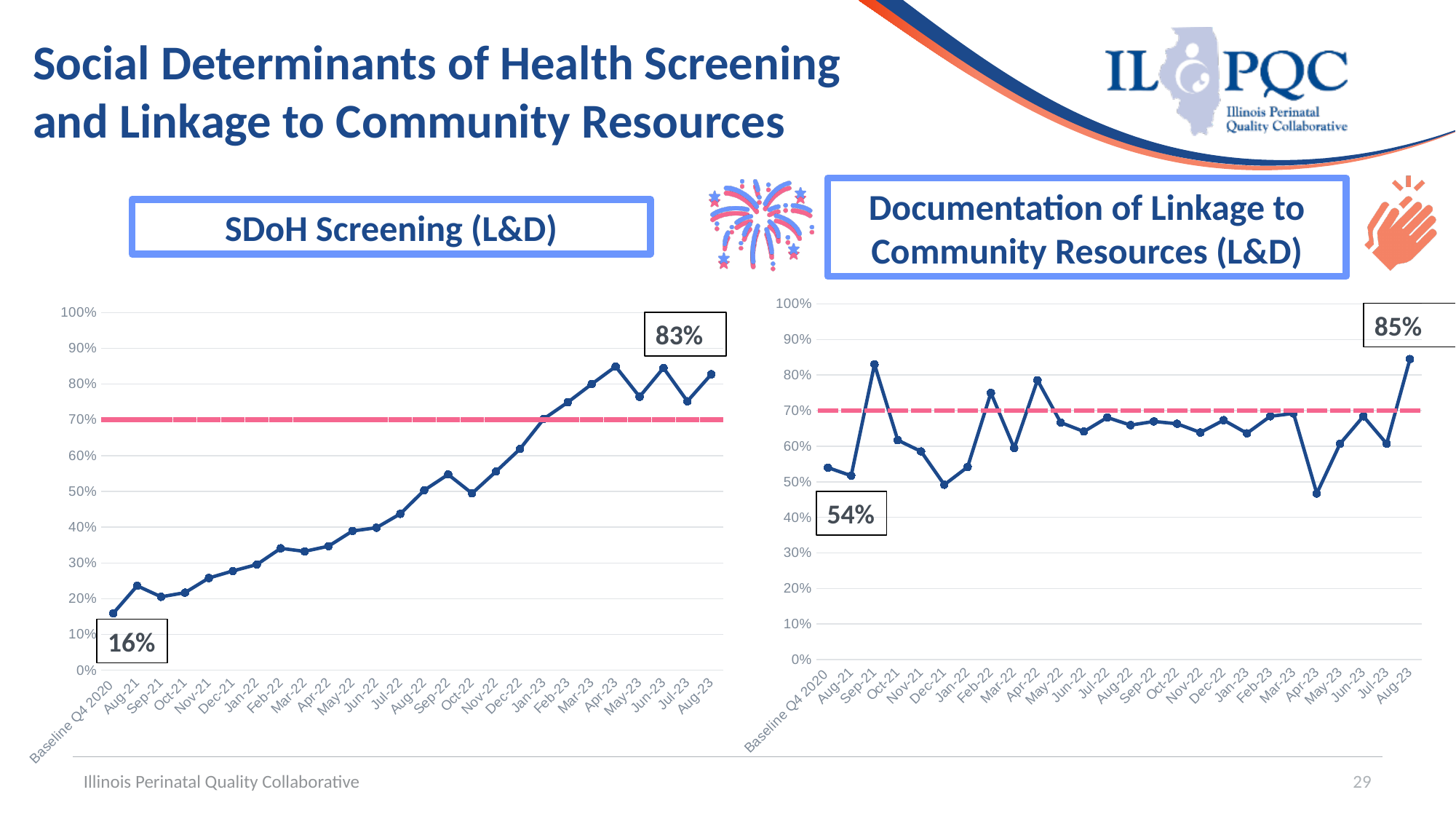
On the SDoH Screening (L&D) chart, which time point has the lowest value? Baseline Q4 2020 On the SDoH Screening (L&D) chart, by how many percentage points did the value increase from Baseline Q4 2020 to Aug-23? 67 percentage points On the SDoH Screening (L&D) chart, what is the value for Baseline Q4 2020? 16% On the SDoH Screening (L&D) chart, do the values generally rise or fall from Baseline Q4 2020 to Aug-23? Rise On the SDoH Screening (L&D) chart, what is the value for Aug-23? 83% On the Documentation of Linkage to Community Resources (L&D) chart, what is the difference between the Aug-23 value and the Baseline Q4 2020 value? 31 percentage points On the Documentation of Linkage to Community Resources (L&D) chart, what is the value for Baseline Q4 2020? 54% What kind of chart is the SDoH Screening (L&D) chart? Line chart On the SDoH Screening (L&D) chart, is the value for Jan-22 greater or less than 40%? less Which chart has the higher Aug-23 value: SDoH Screening (L&D) or Documentation of Linkage to Community Resources (L&D)? Documentation of Linkage to Community Resources (L&D) On the Documentation of Linkage to Community Resources (L&D) chart, is the value for Apr-22 greater or less than 70%? greater On the Documentation of Linkage to Community Resources (L&D) chart, what is the value for Aug-23? 85%